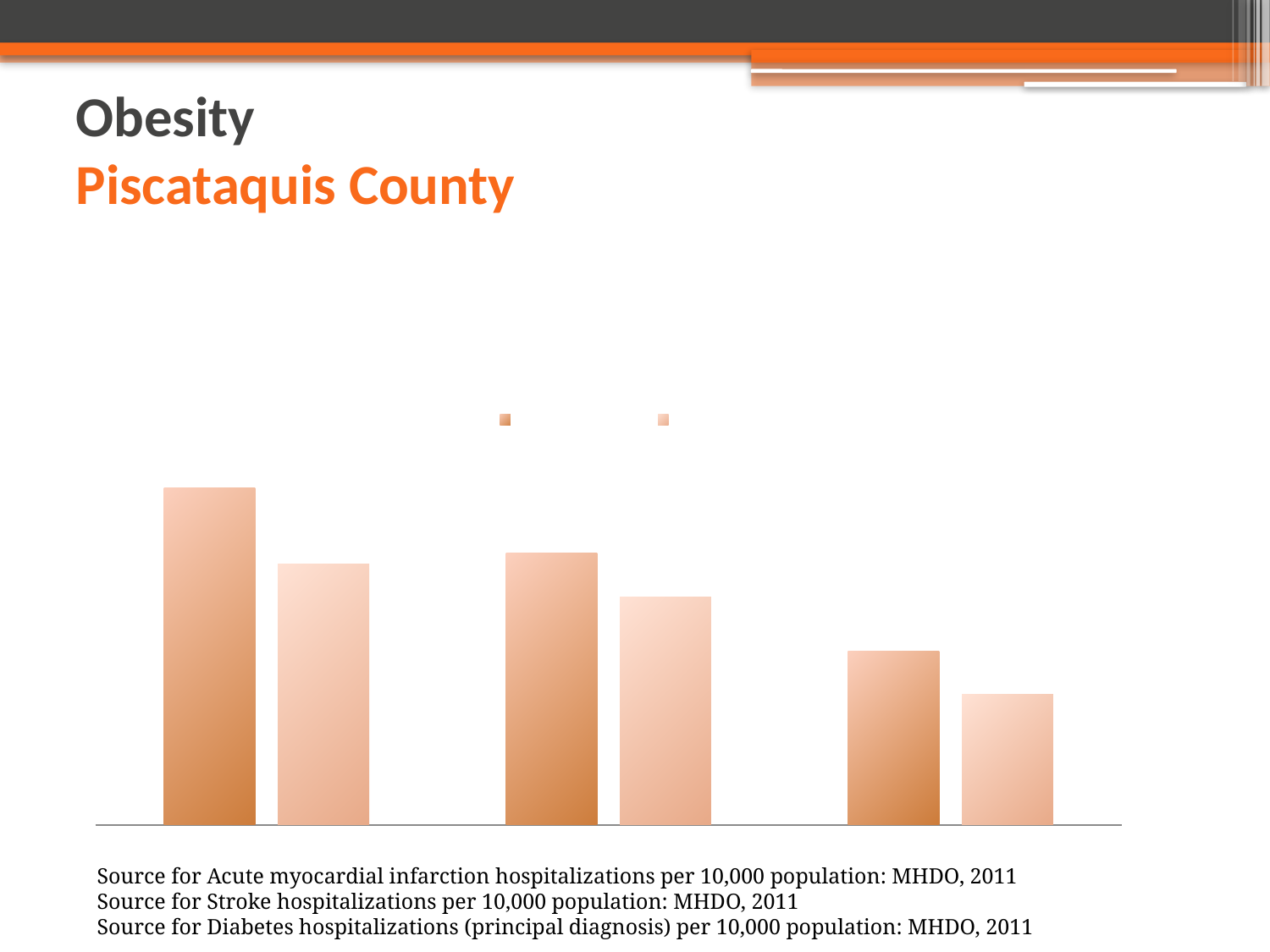
What year is cited in the source notes below the chart? 2011 In each group of bars, is the darker orange bar taller or shorter than the lighter bar beside it? taller What kind of chart is shown on the slide? bar chart Do the bar heights rise or fall from left to right across the chart? fall Which county is named in the slide heading above the chart? Piscataquis County Which group of bars is the tallest: the leftmost, middle, or rightmost? leftmost How many bars are plotted in the chart in total? 6 Which group of bars is the shortest: the leftmost, middle, or rightmost? rightmost How many groups of bars are plotted in the chart? 3 How many series does the chart's legend list? 2